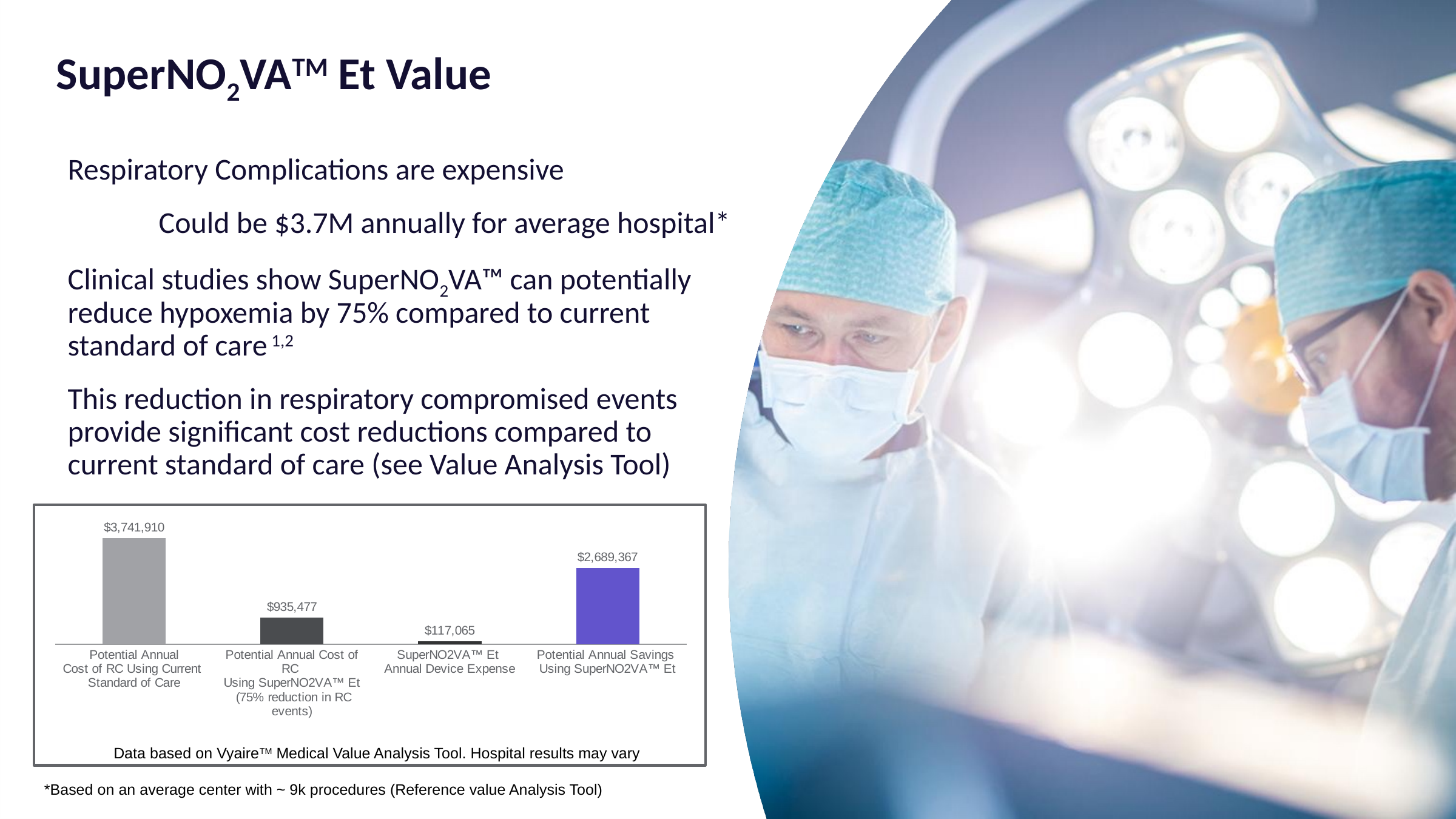
What is the value for Potential Annual Cost of RC Using SuperNO2VA™ Et (75% reduction in RC events)? $935,477 What kind of chart is shown on the slide? Bar chart What is the difference between the Potential Annual Cost of RC Using Current Standard of Care and the Potential Annual Cost of RC Using SuperNO2VA™ Et? $2,806,433 What colour is the bar for Potential Annual Savings Using SuperNO2VA™ Et? Purple What is the SuperNO2VA™ Et Annual Device Expense shown on the chart? $117,065 What is the value for Potential Annual Savings Using SuperNO2VA™ Et? $2,689,367 What is the value for Potential Annual Cost of RC Using Current Standard of Care? $3,741,910 How many categories are shown on the chart? 4 Which is larger: Potential Annual Savings Using SuperNO2VA™ Et or Potential Annual Cost of RC Using SuperNO2VA™ Et? Potential Annual Savings Using SuperNO2VA™ Et What is the difference between the Potential Annual Cost of RC Using SuperNO2VA™ Et and the SuperNO2VA™ Et Annual Device Expense? $818,412 Which category has the lowest value on the chart? SuperNO2VA™ Et Annual Device Expense Which category has the highest value on the chart? Potential Annual Cost of RC Using Current Standard of Care